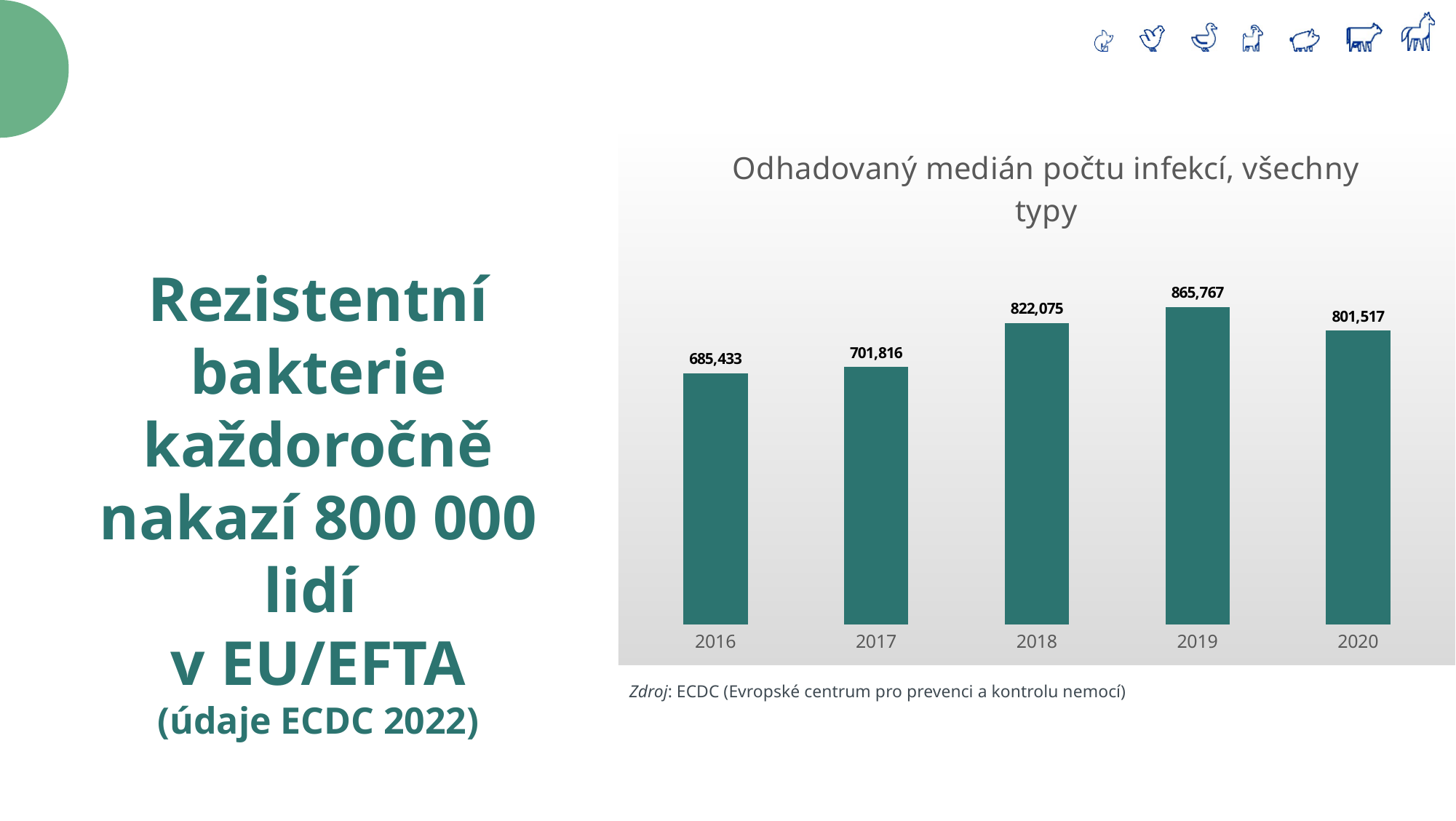
What is the title of the chart? Odhadovaný medián počtu infekcí, všechny typy Do the values rise or fall from 2016 to 2019? rise Which is larger, the value for 2017 or the value for 2020? 2020 Which year has the highest value? 2019 What kind of chart is this? bar chart How many years are shown on the x axis? 5 What is the difference between the values for 2019 and 2018? 43,692 What is the value for 2018? 822,075 What is the value for 2016? 685,433 What is the value for 2020? 801,517 Which year has the lowest value? 2016 What is the difference between the values for 2019 and 2020? 64,250